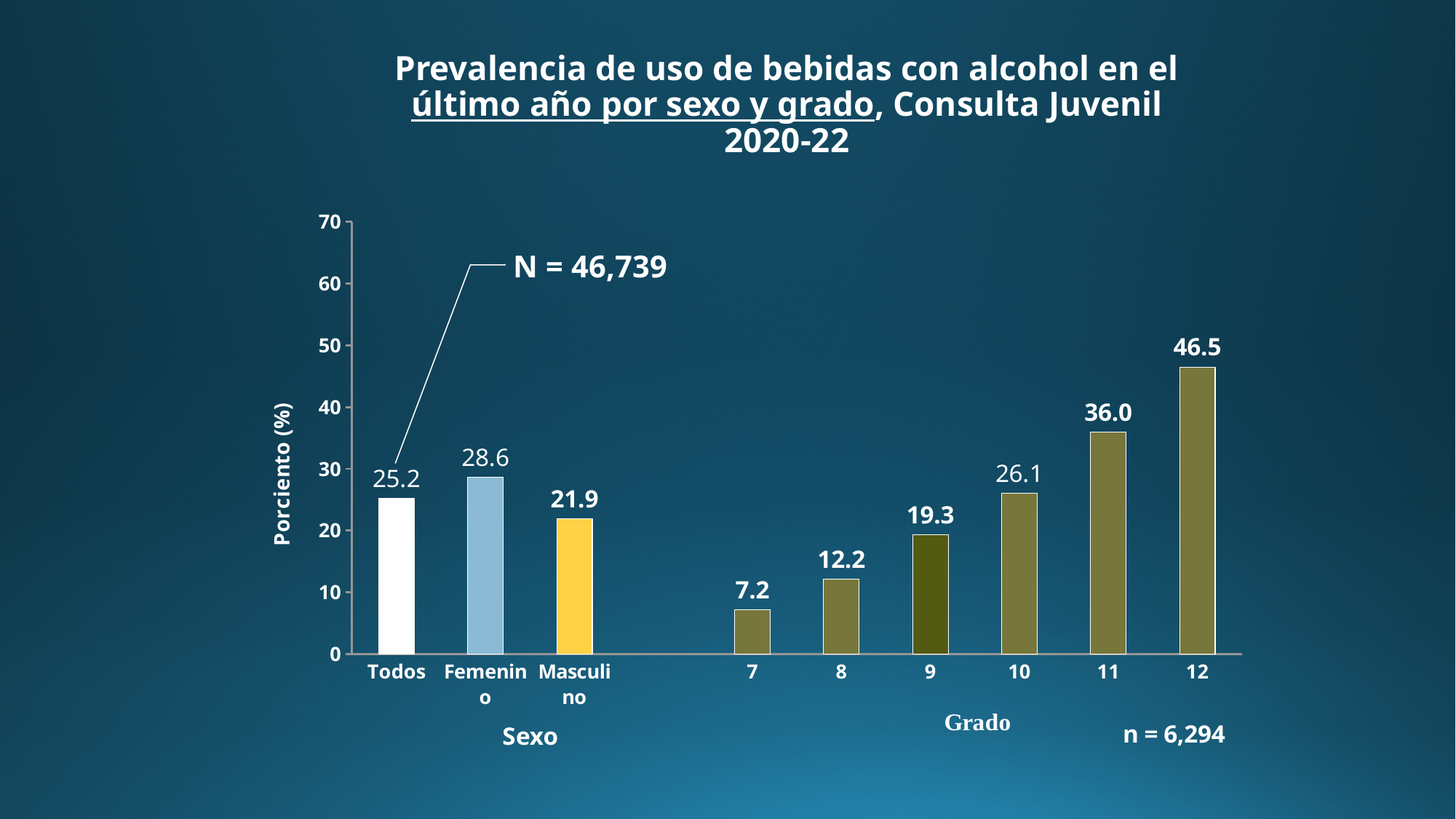
What kind of chart is shown? bar chart Which is larger, the value for grade 10 or the value for Todos? grade 10 What is the value for grade 9? 19.3 What is the difference between the values for grade 12 and grade 11? 10.5 What is the value for Todos? 25.2 What is the value for Femenino? 28.6 What is the value for grade 12? 46.5 Which category has the highest value? 12 What is the difference between the values for Femenino and Masculino? 6.7 Do the values rise or fall from grade 7 to grade 12? rise Which category has the lowest value? 7 How many bars are plotted on the chart? 9